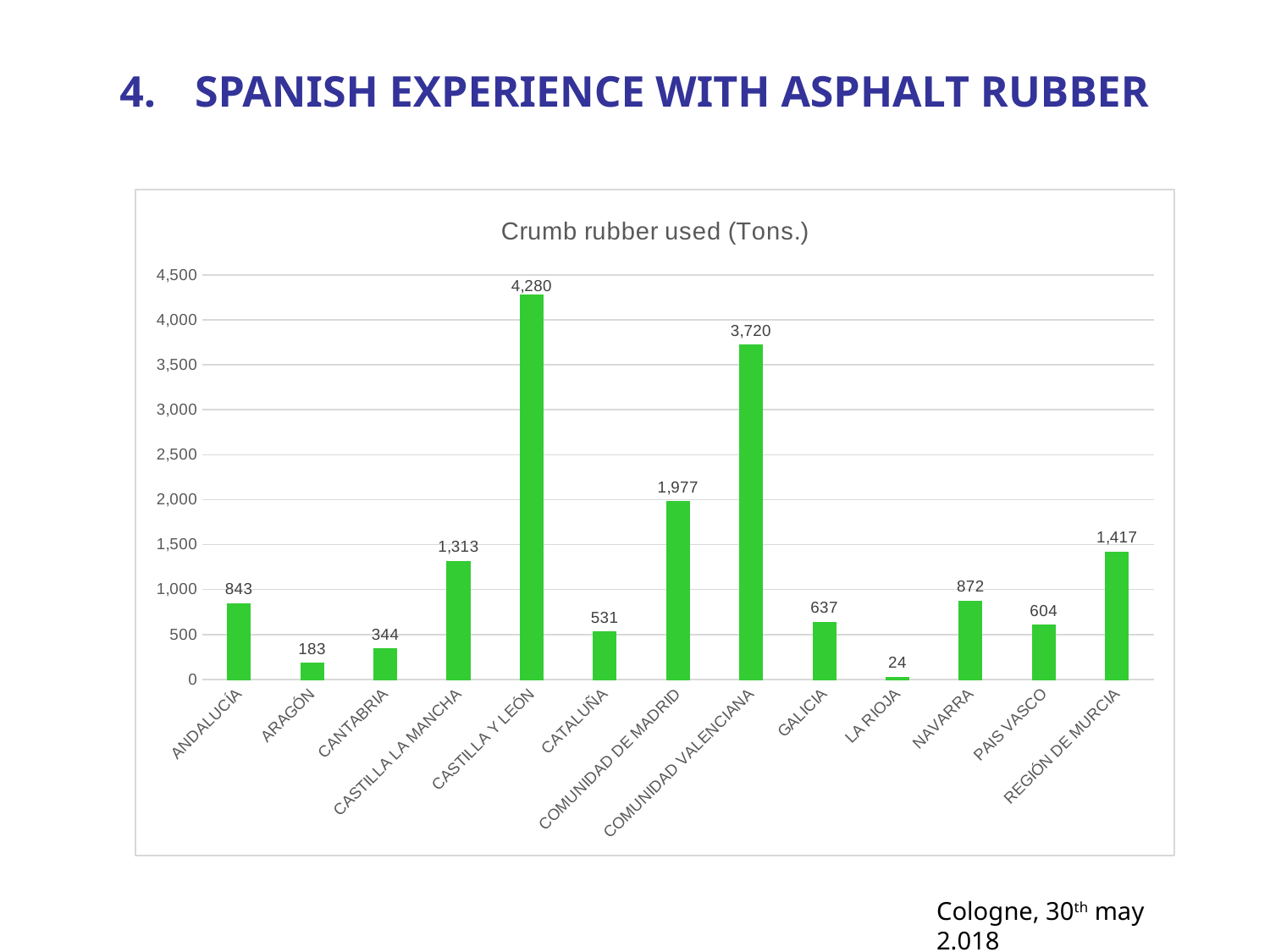
Is the value for REGIÓN DE MURCIA greater or less than 1,000? greater Which is larger, the value for NAVARRA or the value for GALICIA? NAVARRA What is the value for LA RIOJA? 24 What is the value for CASTILLA Y LEÓN? 4,280 What is the difference between the values for CASTILLA Y LEÓN and COMUNIDAD VALENCIANA? 560 What is the value for COMUNIDAD DE MADRID? 1,977 What is the title of the chart? Crumb rubber used (Tons.) Which category has the lowest value? LA RIOJA How many categories are shown on the x axis? 13 What is the difference between the values for ANDALUCÍA and ARAGÓN? 660 What kind of chart is shown? bar chart Which category has the highest value? CASTILLA Y LEÓN